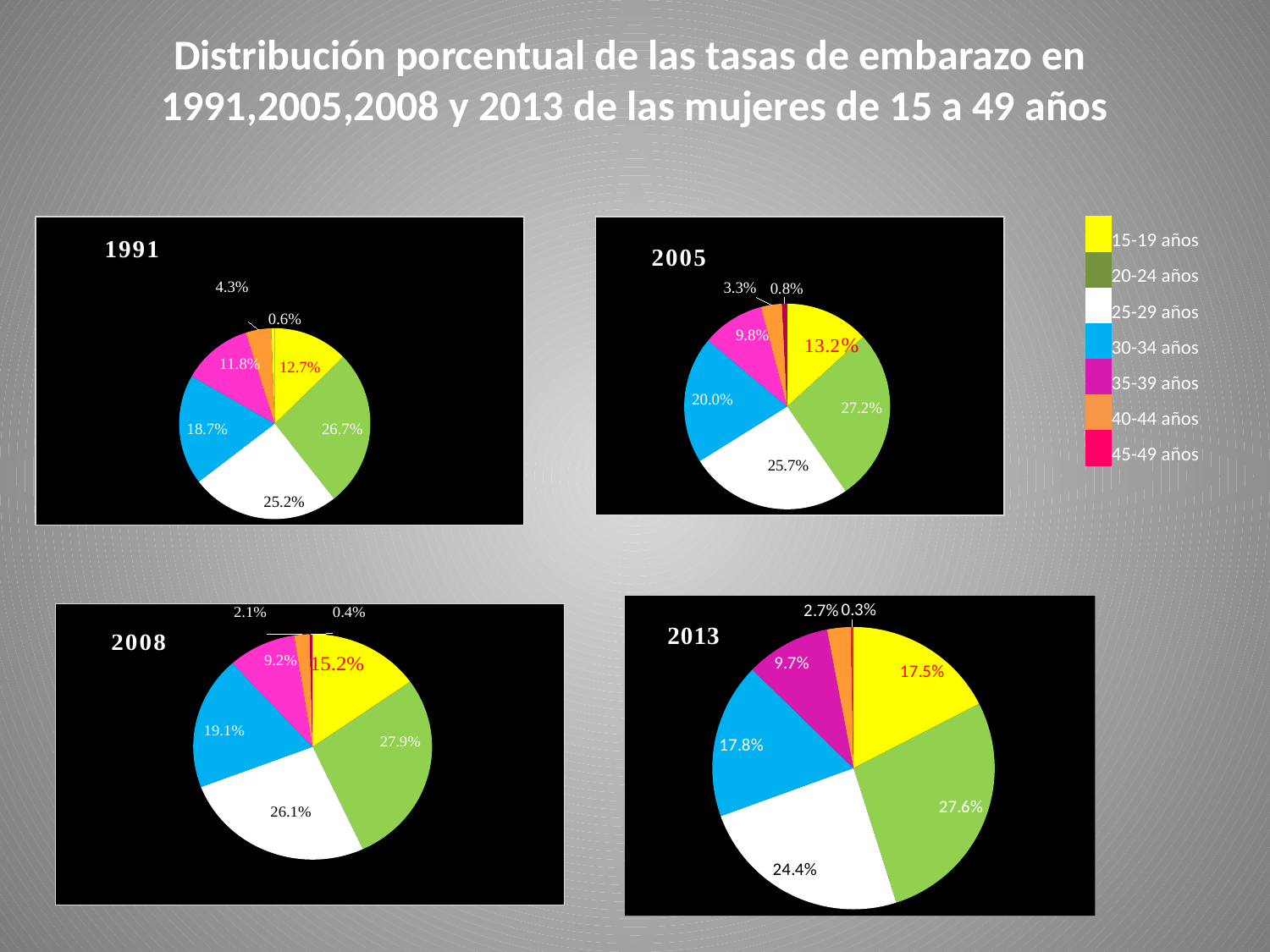
How many pie charts are shown on the slide? 4 In the 2008 pie chart, what is the difference between the shares of the 20-24 años and 25-29 años groups? 1.8% What kind of chart is used for each year on the slide? Pie chart In the 1991 pie chart, what is the share for the 20-24 años group? 26.7% In the 2005 pie chart, which is larger: the share for 35-39 años or the share for 15-19 años? 15-19 años In the 1991 pie chart, which age group has the smallest share? 45-49 años In the 2013 pie chart, what is the share for the 25-29 años group? 24.4% In the 2008 pie chart, what is the share for the 15-19 años group? 15.2% In the 2005 pie chart, what is the share for the 30-34 años group? 20.0% In the 2013 pie chart, which age group has the largest share? 20-24 años How many age groups does the legend list? 7 Which colour represents the 30-34 años group in the legend? Blue